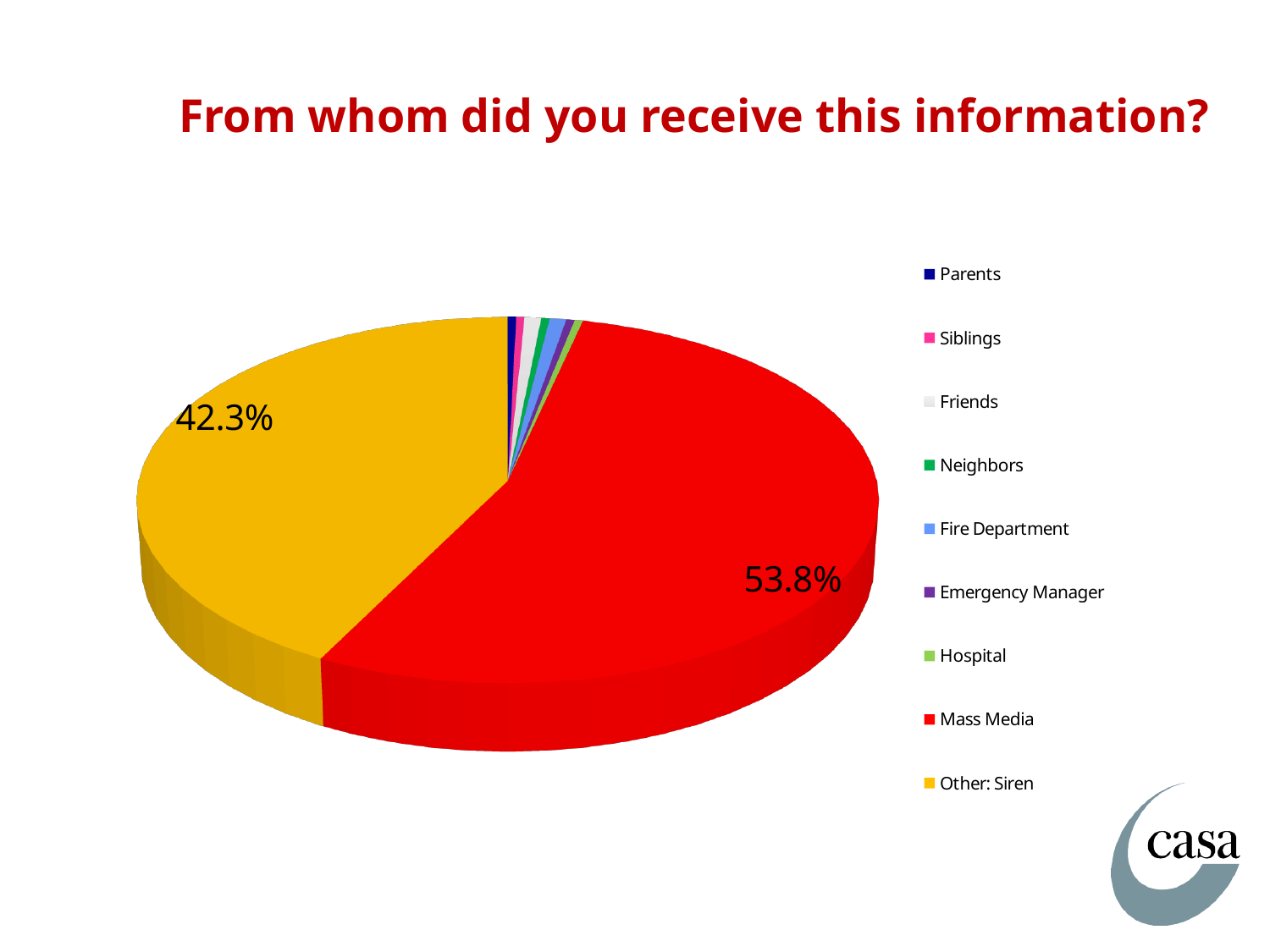
What percentage of the pie is labelled for Mass Media? 53.8% What kind of chart is shown on the slide? pie chart What percentage of the pie is labelled for Other: Siren? 42.3% Which of the two labelled slices is smaller, Mass Media or Other: Siren? Other: Siren By how many percentage points does the Mass Media slice exceed the Other: Siren slice? 11.5 percentage points What is the title of the chart? From whom did you receive this information? Which slice is larger, Mass Media or Other: Siren? Mass Media How many categories does the legend list? 9 Which category is shown in red in the legend? Mass Media What share of the pie does the Other: Siren slice represent? 42.3% Which category has the largest slice of the pie? Mass Media